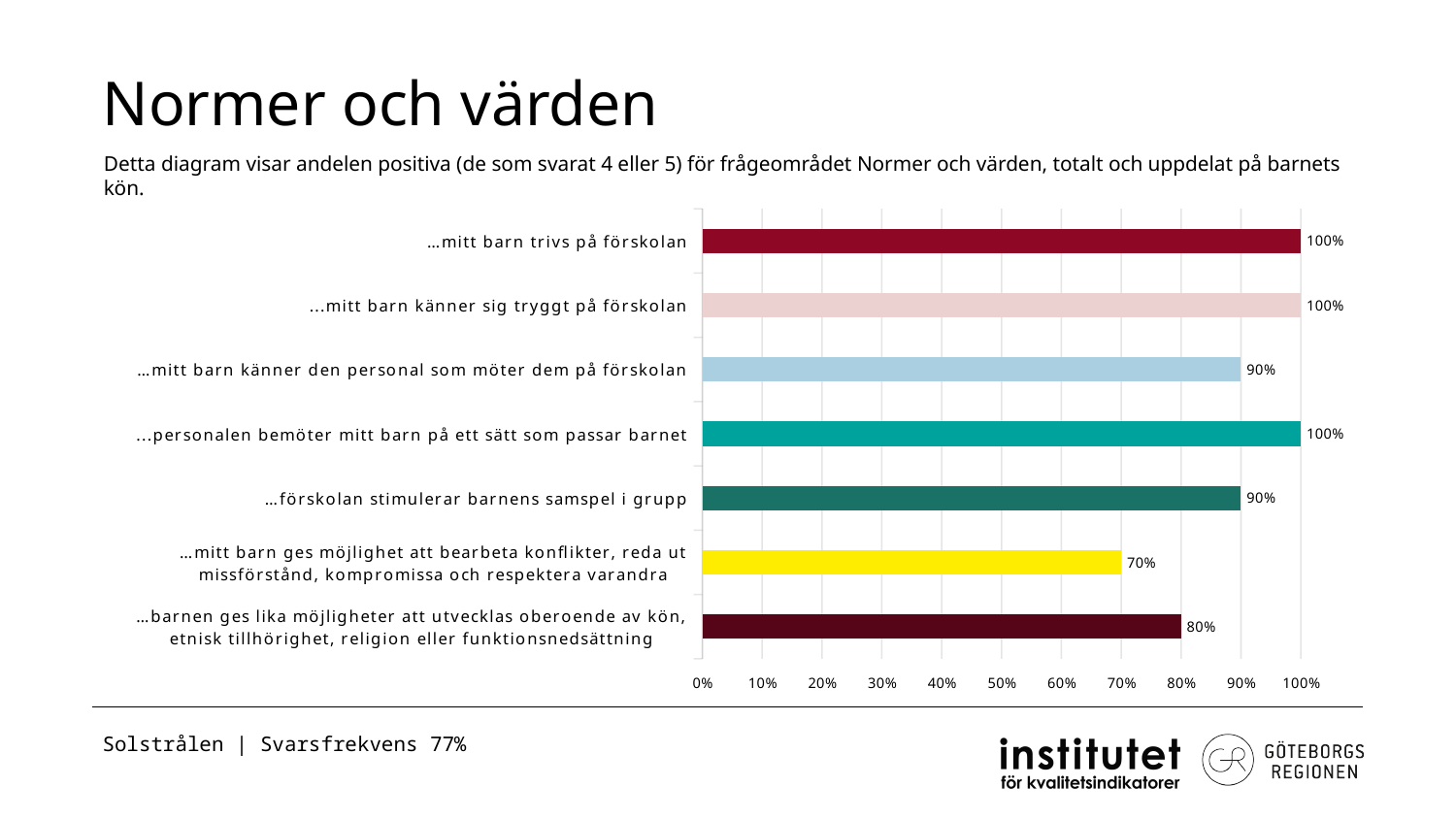
What is the value for "…mitt barn ges möjlighet att bearbeta konflikter, reda ut missförstånd, kompromissa och respektera varandra"? 70% Which category has the lowest value? …mitt barn ges möjlighet att bearbeta konflikter, reda ut missförstånd, kompromissa och respektera varandra What kind of chart is shown on the slide? Bar chart What is the value for "…mitt barn trivs på förskolan"? 100% What is the difference between the value for "…mitt barn trivs på förskolan" and the value for "…mitt barn ges möjlighet att bearbeta konflikter, reda ut missförstånd, kompromissa och respektera varandra"? 30% What is the title of the slide containing the chart? Normer och värden What is the value for "…förskolan stimulerar barnens samspel i grupp"? 90% What is the value for "…mitt barn känner den personal som möter dem på förskolan"? 90% How many categories are shown in the chart? 7 Which is larger: the value for "…förskolan stimulerar barnens samspel i grupp" or the value for "…barnen ges lika möjligheter att utvecklas oberoende av kön, etnisk tillhörighet, religion eller funktionsnedsättning"? …förskolan stimulerar barnens samspel i grupp How many categories have a value of 100%? 3 What is the value for "…barnen ges lika möjligheter att utvecklas oberoende av kön, etnisk tillhörighet, religion eller funktionsnedsättning"? 80%